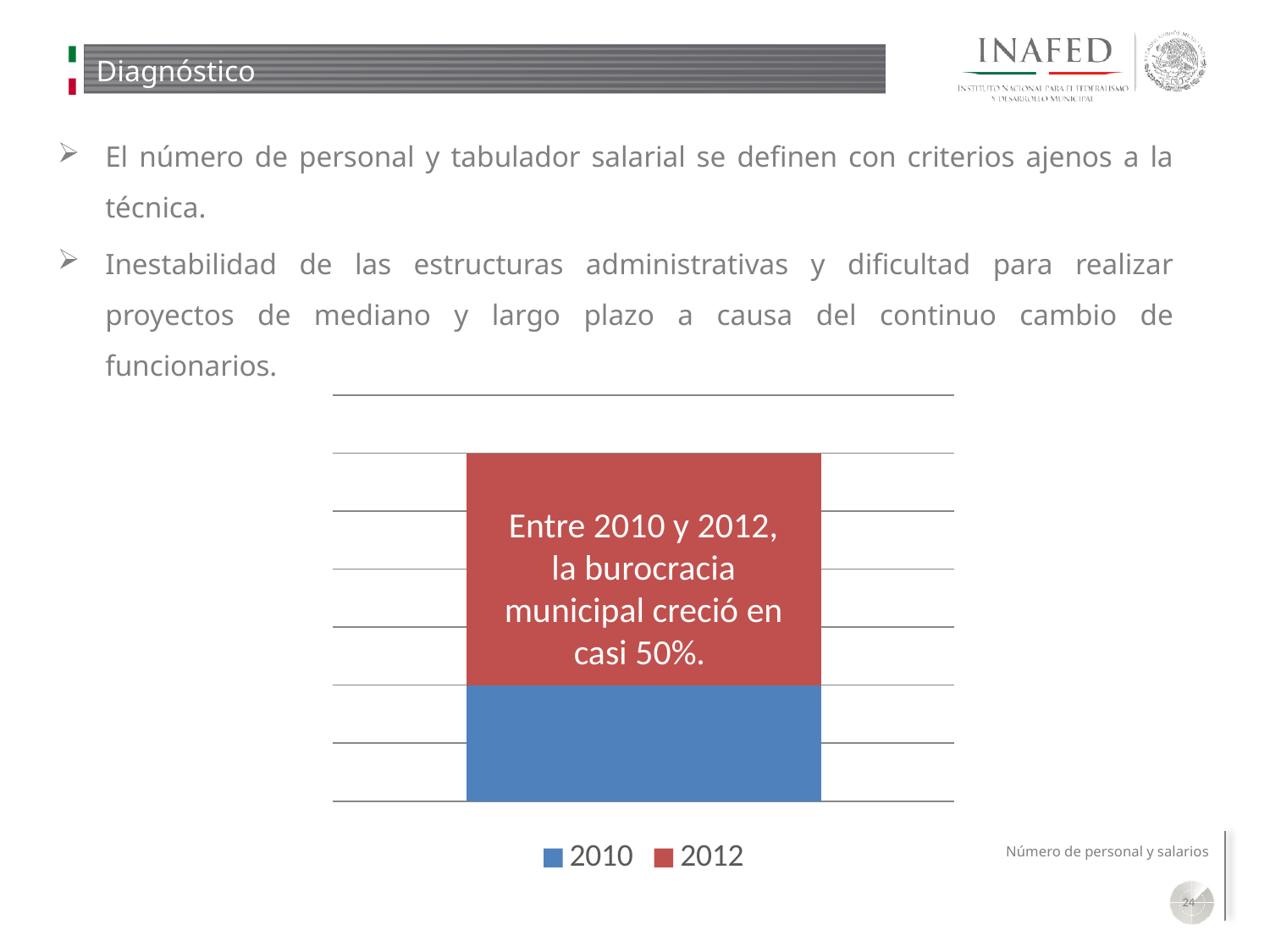
Which two series are listed in the chart's legend? 2010 and 2012 Which colour represents the 2012 series in the chart? red Which series occupies the bottom segment of the stacked bar? 2010 Which segment of the stacked bar is larger, 2010 or 2012? 2012 Which series occupies the top segment of the stacked bar? 2012 How many stacked bars are plotted in the chart? 1 What kind of chart is shown on the slide? bar chart How many series does the chart's legend list? 2